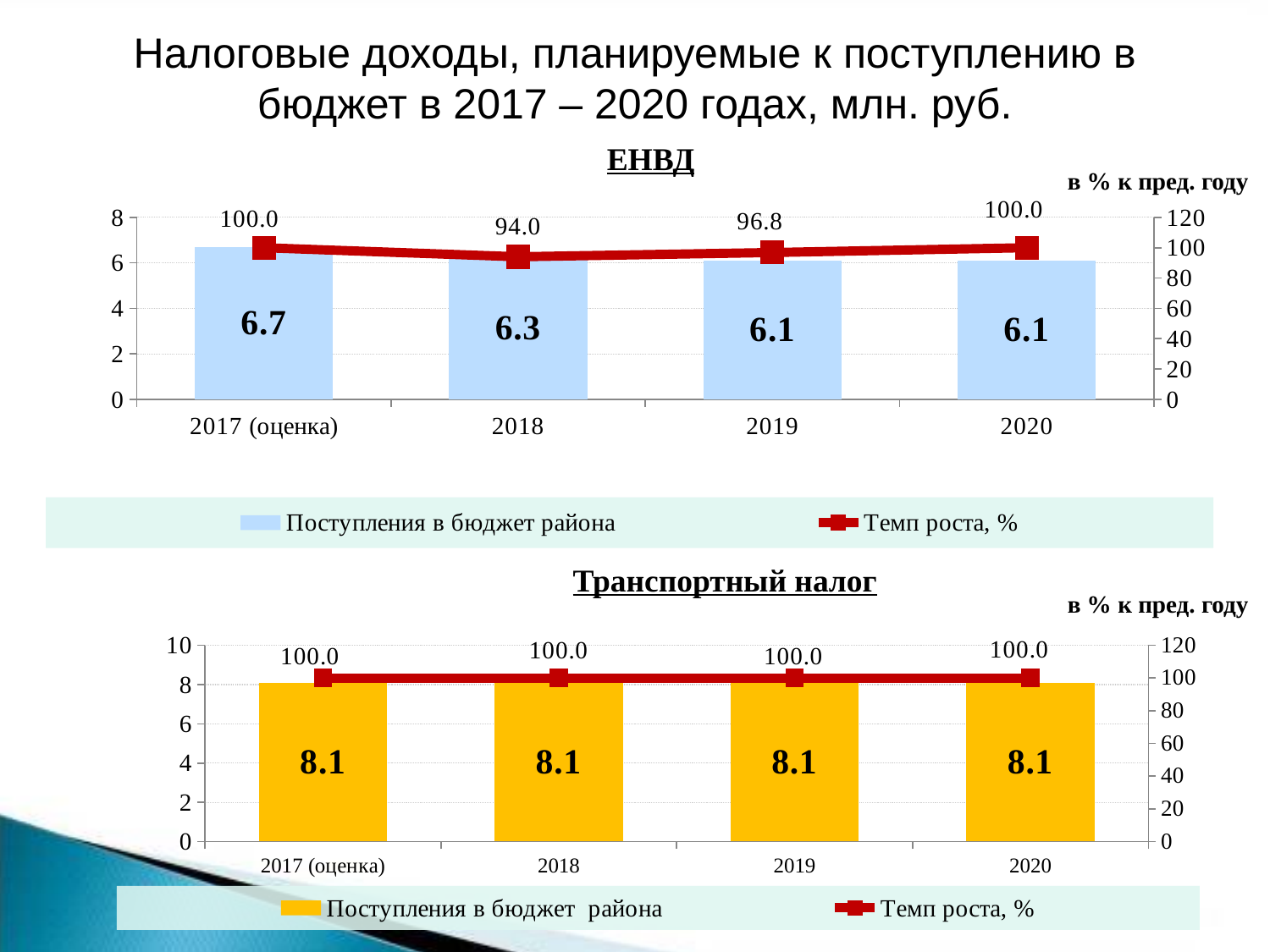
How many series does the legend of the ЕНВД chart list? 2 In the ЕНВД chart, which year has the lowest Темп роста, % value? 2018 What colour are the bars in the Транспортный налог chart? Yellow In the ЕНВД chart, what is the Темп роста, % value for 2019? 96.8 In the ЕНВД chart, which year has the highest value of Поступления в бюджет района? 2017 (оценка) How many years are shown on the x axis of the Транспортный налог chart? 4 In the ЕНВД chart, what is the value of Поступления в бюджет района for 2018? 6.3 In the Транспортный налог chart, what is the Темп роста, % value for 2020? 100.0 In the ЕНВД chart, do the Поступления в бюджет района values rise or fall from 2017 (оценка) to 2019? fall In the Транспортный налог chart, what is the value of Поступления в бюджет района for 2019? 8.1 In the ЕНВД chart, what is the difference between Поступления в бюджет района in 2017 (оценка) and in 2020? 0.6 In the ЕНВД chart, is Поступления в бюджет района larger in 2017 (оценка) or in 2018? 2017 (оценка)